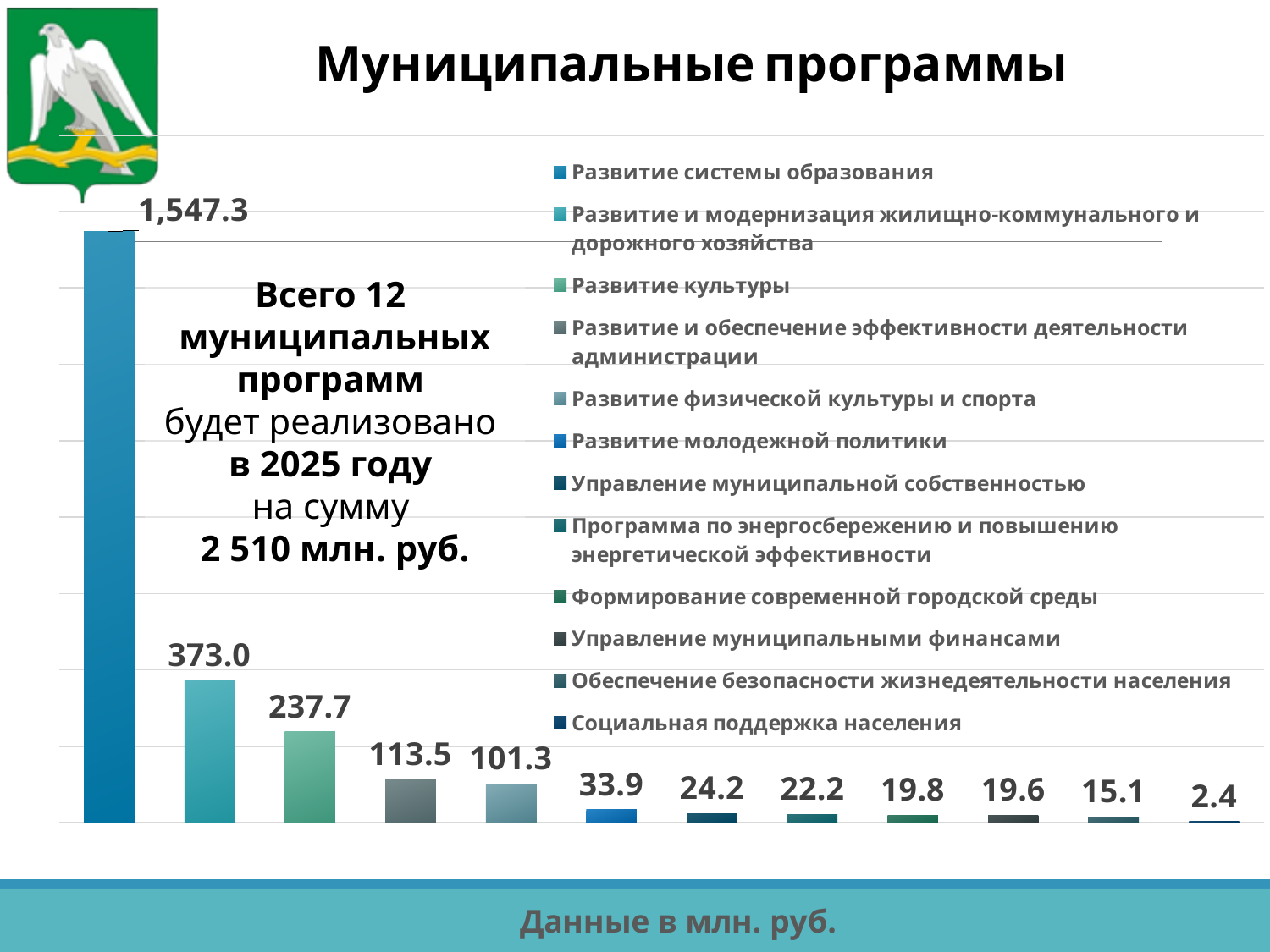
What type of chart is shown on the slide? bar chart What is the value of the tallest bar in the chart? 1,547.3 How many entries does the legend list? 12 What is the value for 'Развитие физической культуры и спорта'? 101.3 What is the value for 'Развитие культуры'? 237.7 How many bars (municipal programs) are plotted in the chart? 12 What is the value of the smallest bar in the chart? 2.4 In what units are the chart data given, according to the footer? млн. руб. What is the difference between the values 373.0 and 237.7 shown for the second and third bars? 135.3 What is the value for 'Развитие и модернизация жилищно-коммунального и дорожного хозяйства'? 373.0 Which is larger: the value for 'Развитие молодежной политики' (33.9) or for 'Управление муниципальной собственностью' (24.2)? Развитие молодежной политики Do the bar values rise or fall from left to right across the chart? fall